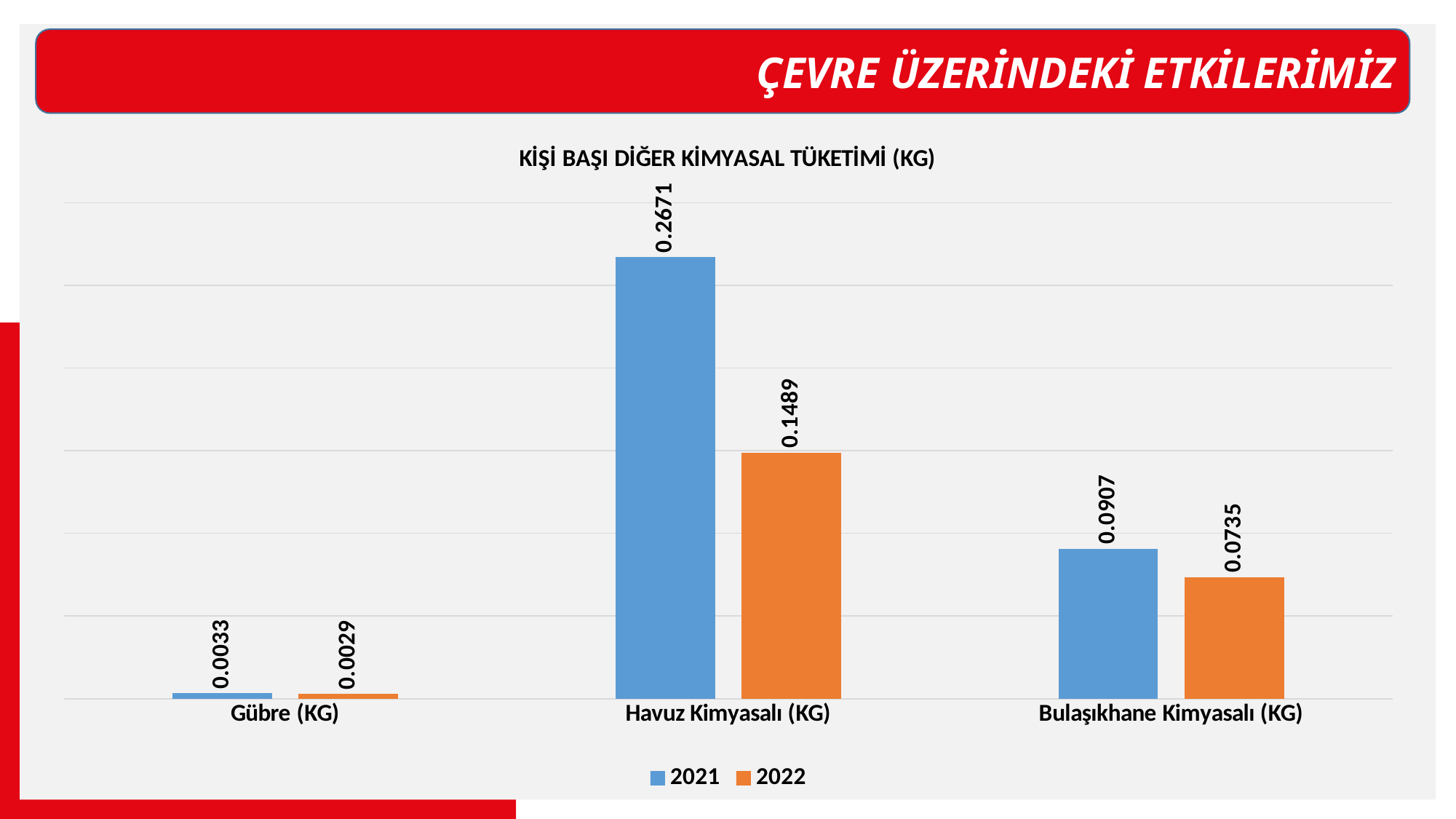
What is the 2022 value for Gübre (KG)? 0.0029 What is the difference between the 2021 and 2022 values for Havuz Kimyasalı (KG)? 0.1182 What is the 2021 value for Bulaşıkhane Kimyasalı (KG)? 0.0907 Which is larger for Bulaşıkhane Kimyasalı (KG): the 2021 value or the 2022 value? 2021 What is the title of the chart? KİŞİ BAŞI DİĞER KİMYASAL TÜKETİMİ (KG) Which category has the highest 2021 value? Havuz Kimyasalı (KG) What kind of chart is shown on the slide? Bar chart What is the 2021 value for Havuz Kimyasalı (KG)? 0.2671 What is the 2022 value for Bulaşıkhane Kimyasalı (KG)? 0.0735 How many categories are shown on the x axis? 3 Which category has the lowest 2022 value? Gübre (KG) How many series does the legend list? 2